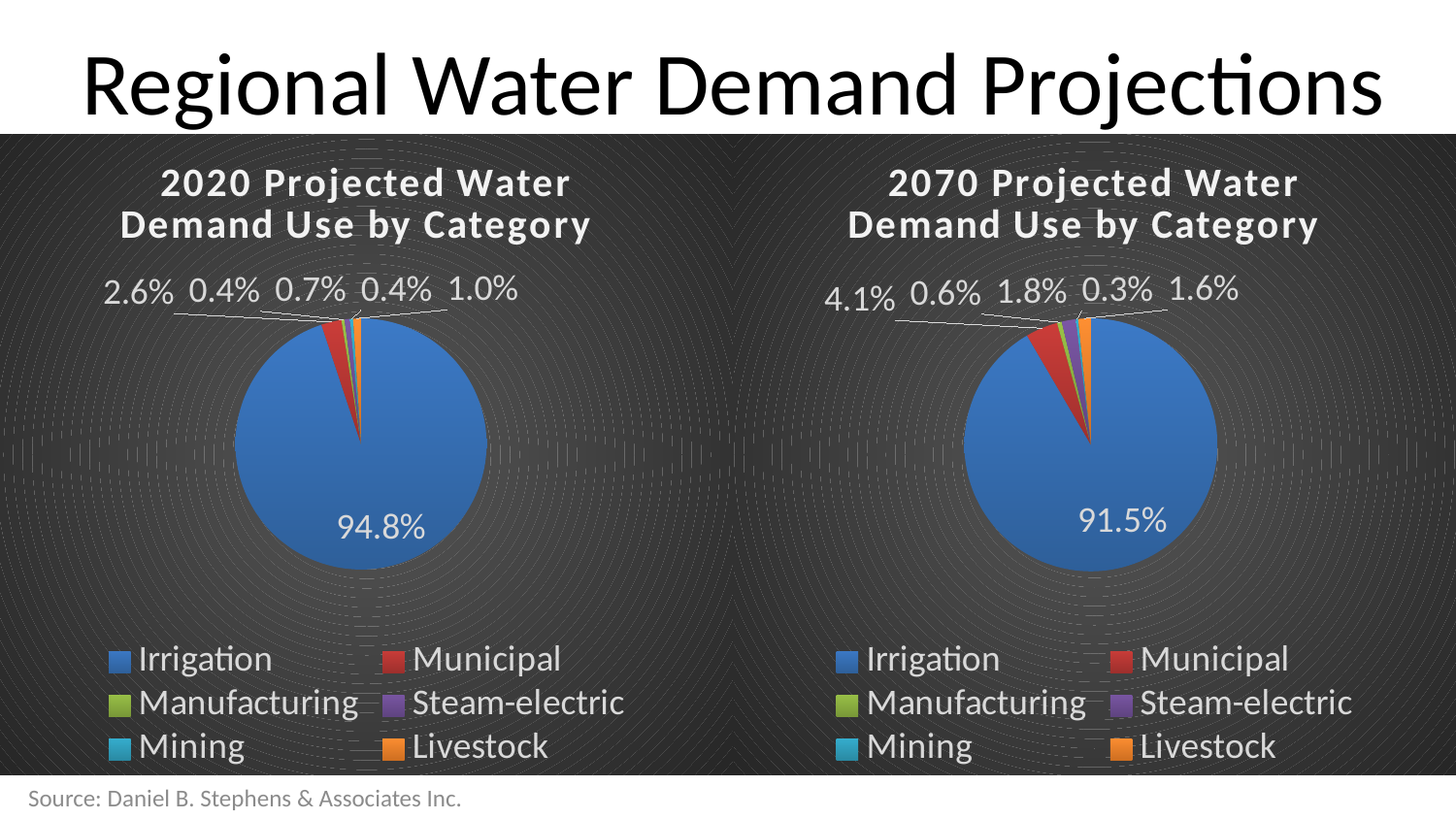
In the 2020 Projected Water Demand Use by Category chart, what is the value for Municipal? 2.6% In the 2020 Projected Water Demand Use by Category chart, what share does Irrigation have? 94.8% How many categories does the 2020 Projected Water Demand Use by Category chart show? 6 In the 2070 Projected Water Demand Use by Category chart, what is the value for Municipal? 4.1% In the 2020 Projected Water Demand Use by Category chart, which category has the largest share? Irrigation What type of chart is the 2070 Projected Water Demand Use by Category chart? Pie chart In the 2070 Projected Water Demand Use by Category chart, what is the value for Steam-electric? 1.8% What is the title of the chart on the left side of the slide? 2020 Projected Water Demand Use by Category How much larger is the Irrigation share in the 2020 chart than in the 2070 chart? 3.3 percentage points Is the Municipal share larger in the 2020 chart or the 2070 chart? 2070 In the 2070 Projected Water Demand Use by Category chart, which category has the smallest share? Mining In the 2070 Projected Water Demand Use by Category chart, what share does Irrigation have? 91.5%